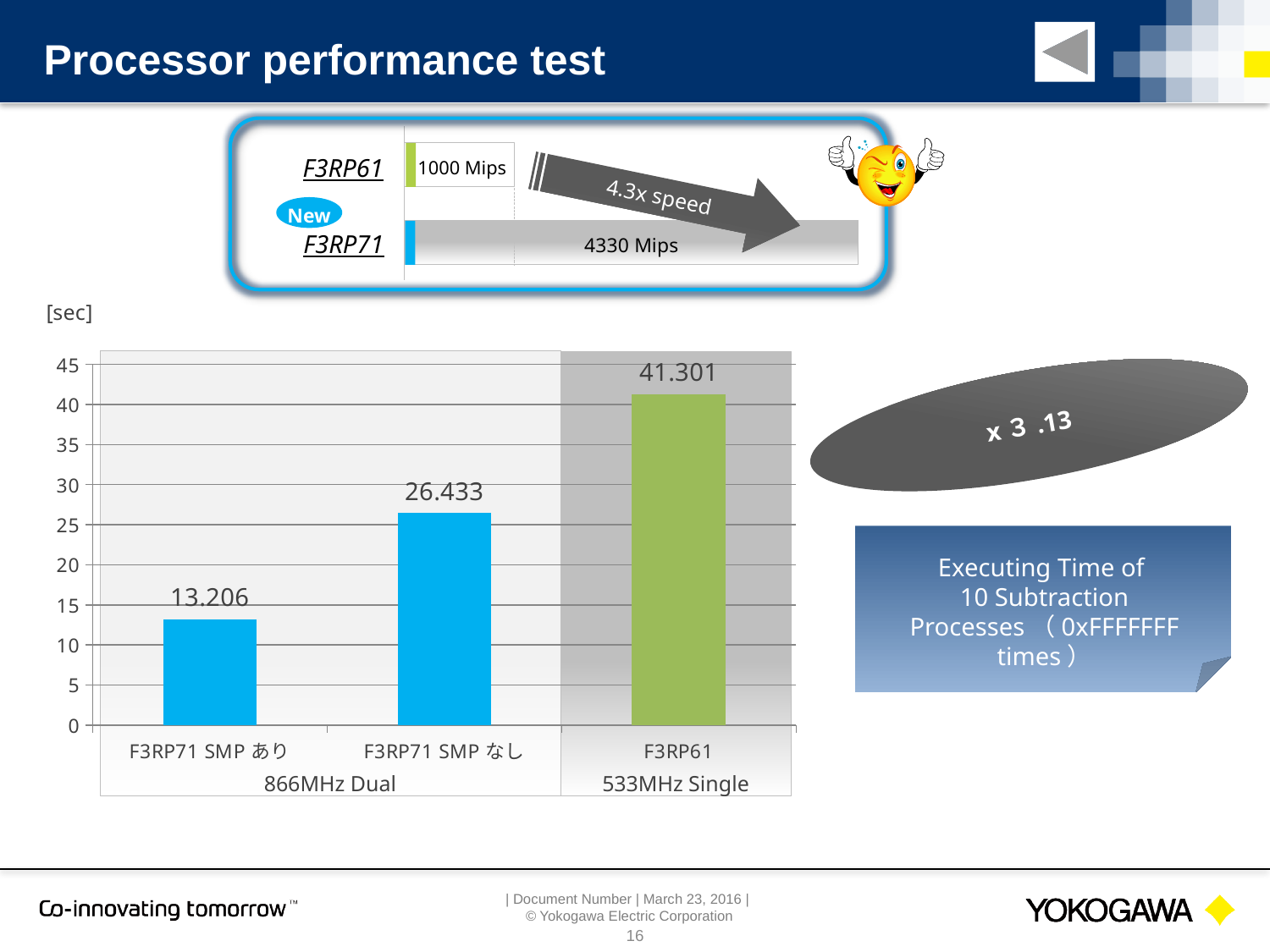
What kind of chart is shown on the slide? bar chart Is the value for F3RP71 SMP なし greater or less than 25? greater What unit is shown above the vertical axis of the chart? [sec] How many bars are plotted in the chart? 3 What is the value for F3RP61? 41.301 What is the difference between the values for F3RP61 and F3RP71 SMP あり? 28.095 Which is larger, the value for F3RP71 SMP なし or the value for F3RP61? F3RP61 What is the value for F3RP71 SMP なし? 26.433 What is the value for F3RP71 SMP あり? 13.206 Which category has the highest value? F3RP61 What is the difference between the values for F3RP71 SMP なし and F3RP71 SMP あり? 13.227 Which category has the lowest value? F3RP71 SMP あり